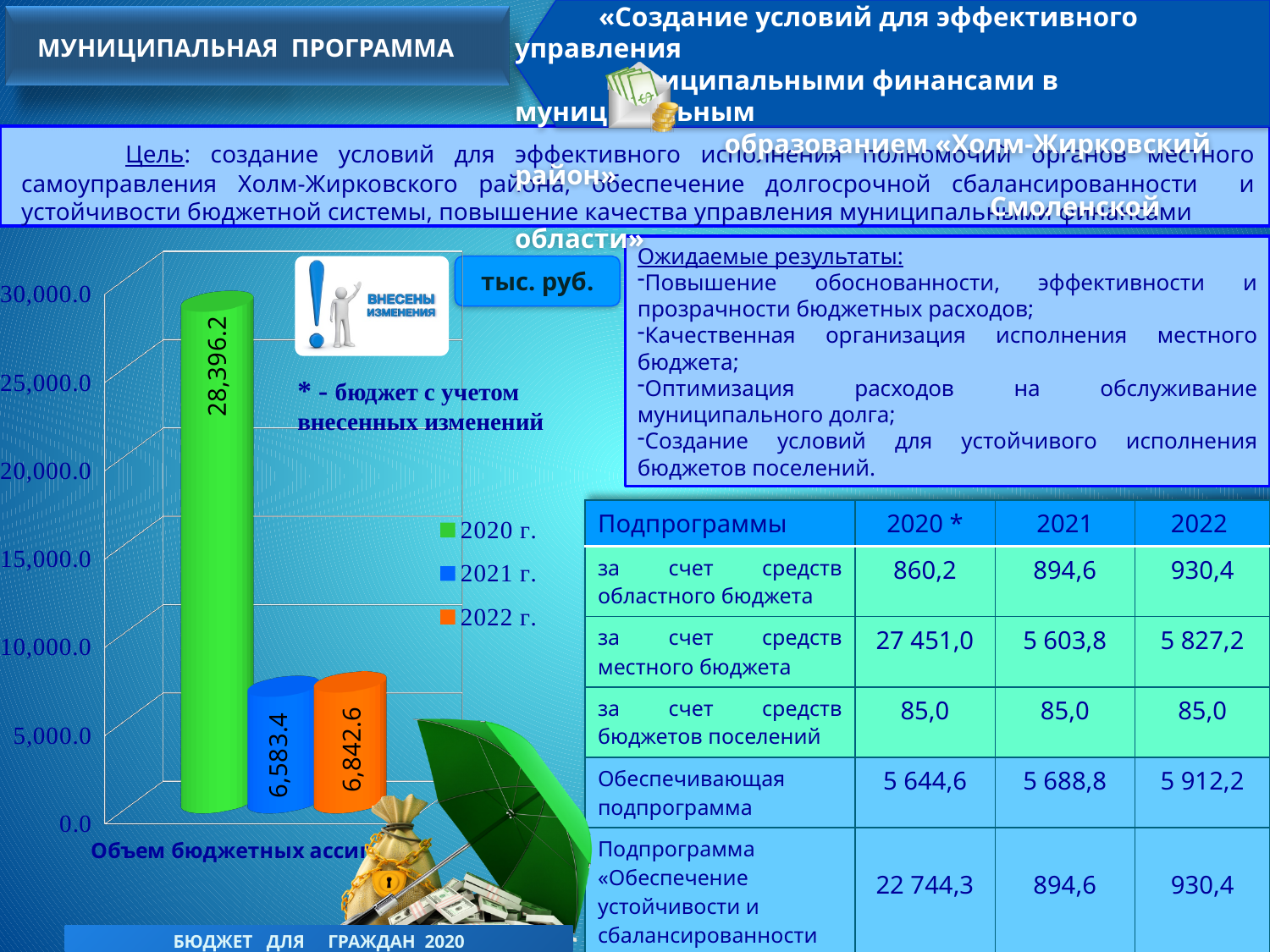
What is the value of the 2020 г. bar in the chart? 28,396.2 Which year has the lowest value in the chart? 2021 г. What unit is indicated for the values in the chart? тыс. руб. What is the value of the 2022 г. bar in the chart? 6,842.6 What kind of chart is shown on the slide? bar chart Is the value for 2020 г. in the chart greater or less than 25,000.0? greater What is the difference between the 2022 г. and 2021 г. values in the chart? 259.2 Which is larger in the chart, the value for 2021 г. or the value for 2022 г.? 2022 г. What is the value of the 2021 г. bar in the chart? 6,583.4 How many series does the chart legend list? 3 What is the difference between the 2020 г. and 2021 г. values in the chart? 21,812.8 Which year has the highest value in the chart? 2020 г.